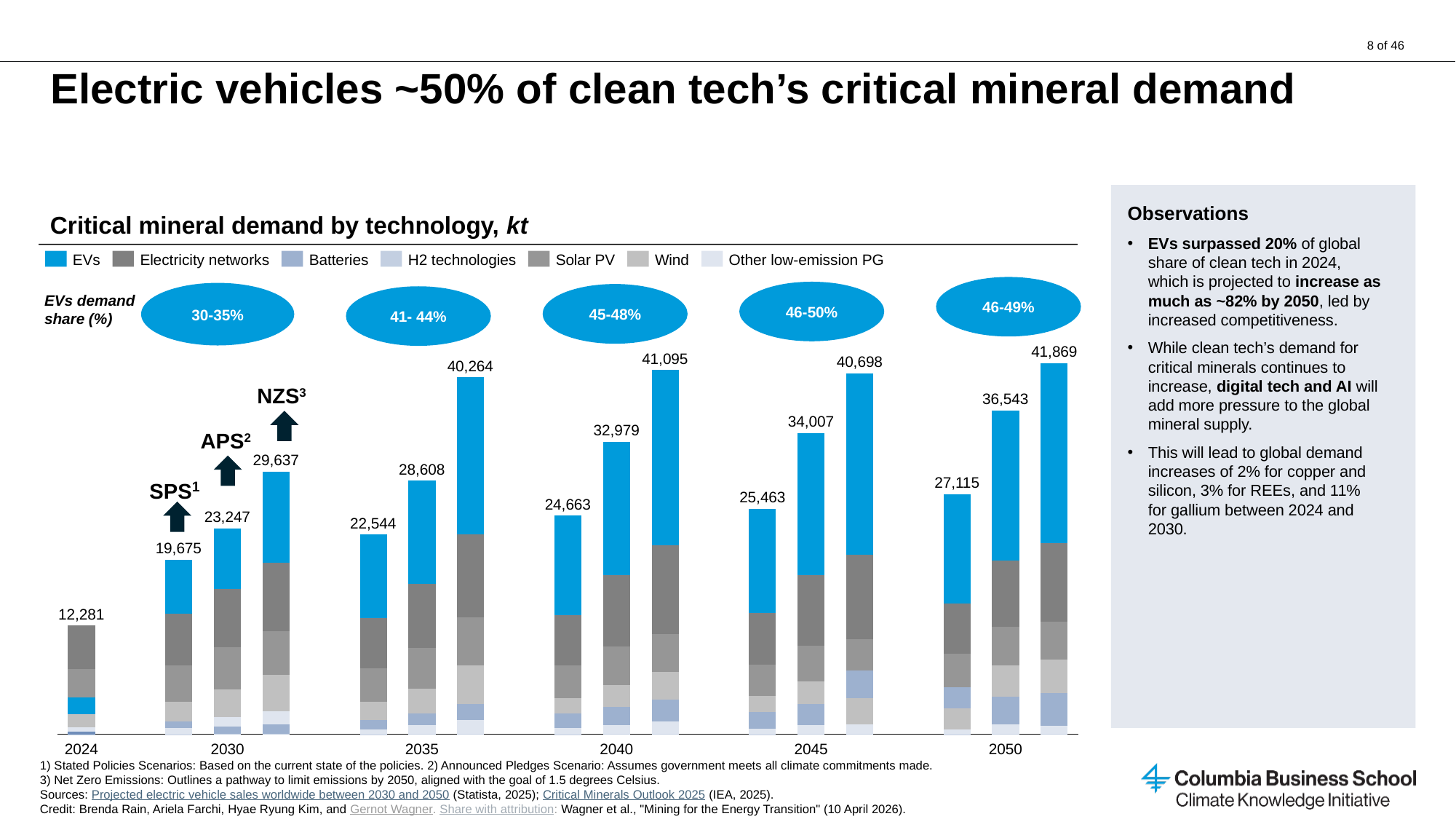
Which bar has the highest total critical mineral demand? NZS in 2050 (41,869) What is the EVs demand share shown for 2050? 46-49% What is the total critical mineral demand for the NZS scenario in 2035? 40,264 What kind of chart is this? Stacked bar chart What is the total critical mineral demand shown for 2024? 12,281 Which bar has the lowest total critical mineral demand? 2024 (12,281) How many years are shown on the x axis? 6 Which is larger, the NZS total in 2040 or the NZS total in 2045? NZS in 2040 (41,095) How many series does the legend list? 7 What is the total critical mineral demand for the APS scenario in 2045? 34,007 What is the difference between the NZS and SPS totals in 2030? 9,962 What is the total critical mineral demand for the SPS scenario in 2050? 27,115